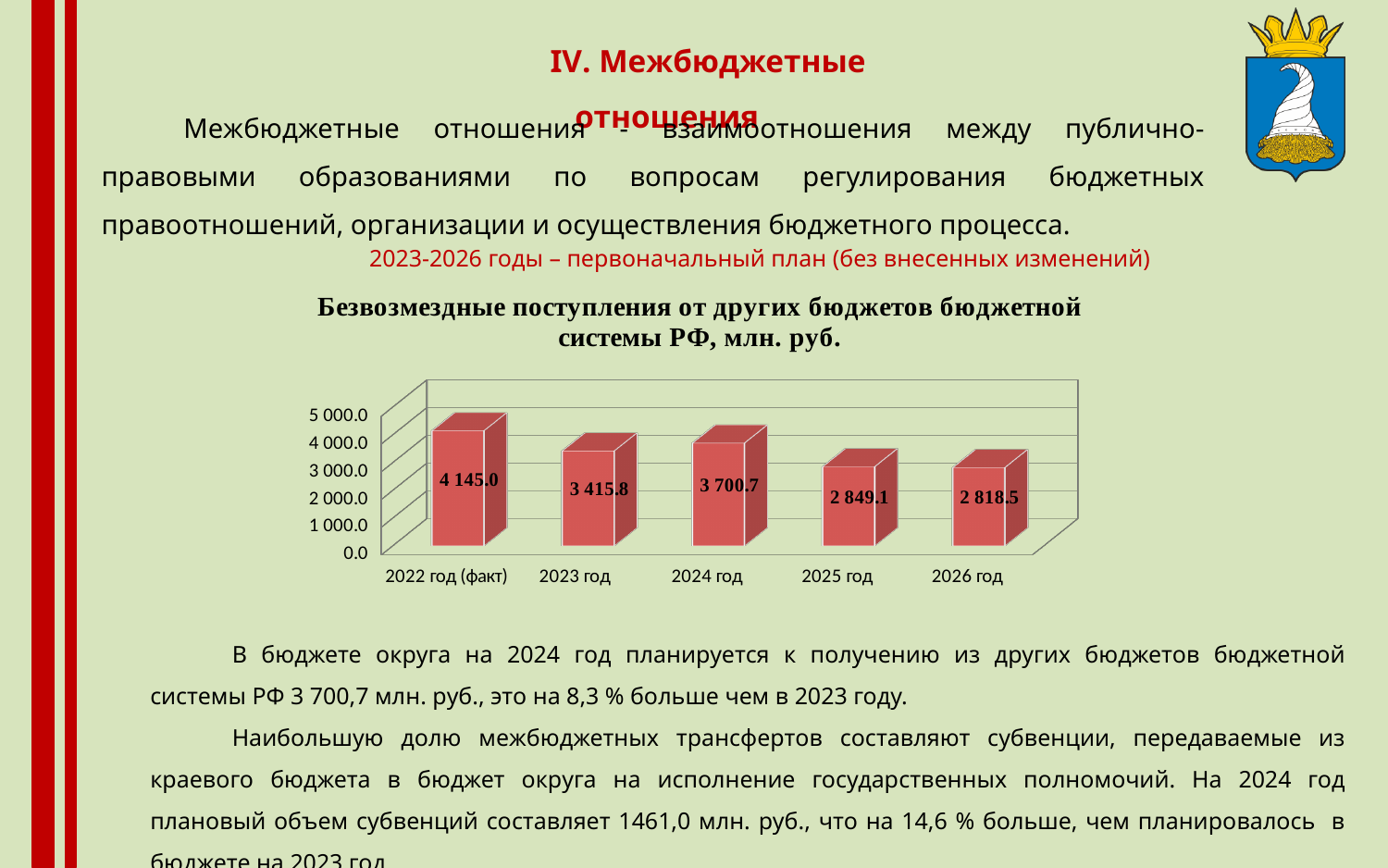
Which category has the highest value in the chart? 2022 год (факт) Which category has the lowest value in the chart? 2026 год How many categories are shown on the x axis of the chart? 5 What is the value for 2022 год (факт) in the chart? 4 145.0 What is the value for 2024 год in the chart? 3 700.7 What is the value for 2026 год in the chart? 2 818.5 What kind of chart is shown on the slide? bar chart What is the title of the chart? Безвозмездные поступления от других бюджетов бюджетной системы РФ, млн. руб. Which is larger, the value for 2023 год or the value for 2024 год? 2024 год What is the difference between the values for 2024 год and 2023 год? 284.9 Is the value for 2025 год greater or less than 3 000.0? less What is the difference between the values for 2022 год (факт) and 2026 год? 1 326.5